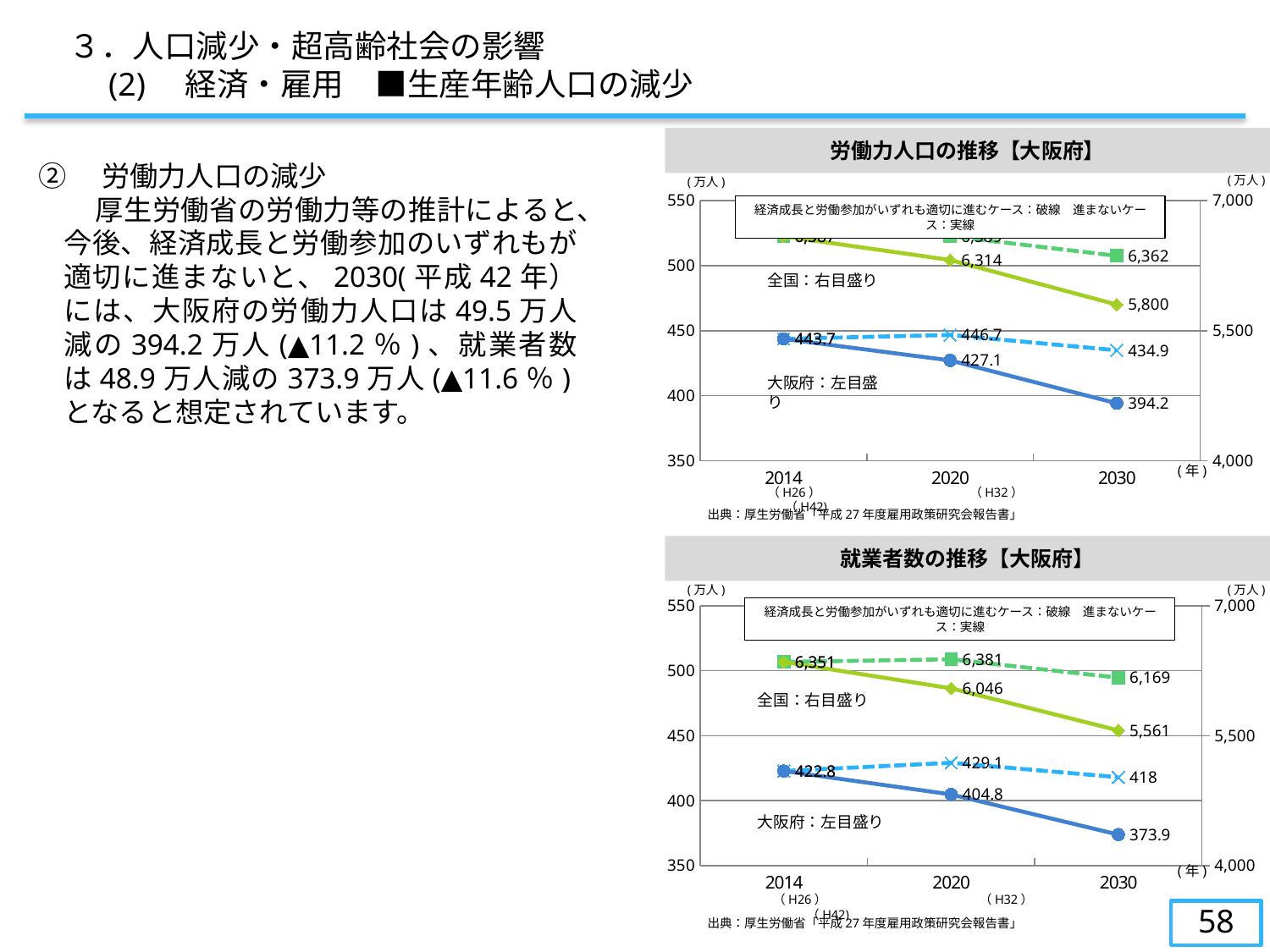
How many years are shown on the x axis of the bottom chart (就業者数の推移【大阪府】)? 3 In the top chart (労働力人口の推移【大阪府】), what is the value of the dashed Osaka line in 2030? 434.9 In the bottom chart (就業者数の推移【大阪府】), which is larger in 2030: the dashed Osaka line (418) or the solid Osaka line (373.9)? the dashed Osaka line (418) In the top chart (労働力人口の推移【大阪府】), what is the value of the solid Osaka line (大阪府) in 2030? 394.2 In the top chart (労働力人口の推移【大阪府】), by how much does the solid Osaka line fall from 2014 (443.7) to 2030 (394.2)? 49.5 In the bottom chart (就業者数の推移【大阪府】), what is the value of the dashed national line (全国) in 2014? 6,351 What kind of chart is the top chart titled 労働力人口の推移【大阪府】? line chart In the top chart (労働力人口の推移【大阪府】), what is the value of the solid national line (全国) in 2030? 5,800 In the top chart (労働力人口の推移【大阪府】), does the solid Osaka line rise or fall from 2014 to 2030? fall In the top chart (労働力人口の推移【大阪府】), what is the value of the solid Osaka line (大阪府) in 2020? 427.1 In the bottom chart (就業者数の推移【大阪府】), what is the value of the solid national line (全国) in 2030? 5,561 In the bottom chart (就業者数の推移【大阪府】), what is the value of the solid Osaka line in 2030? 373.9